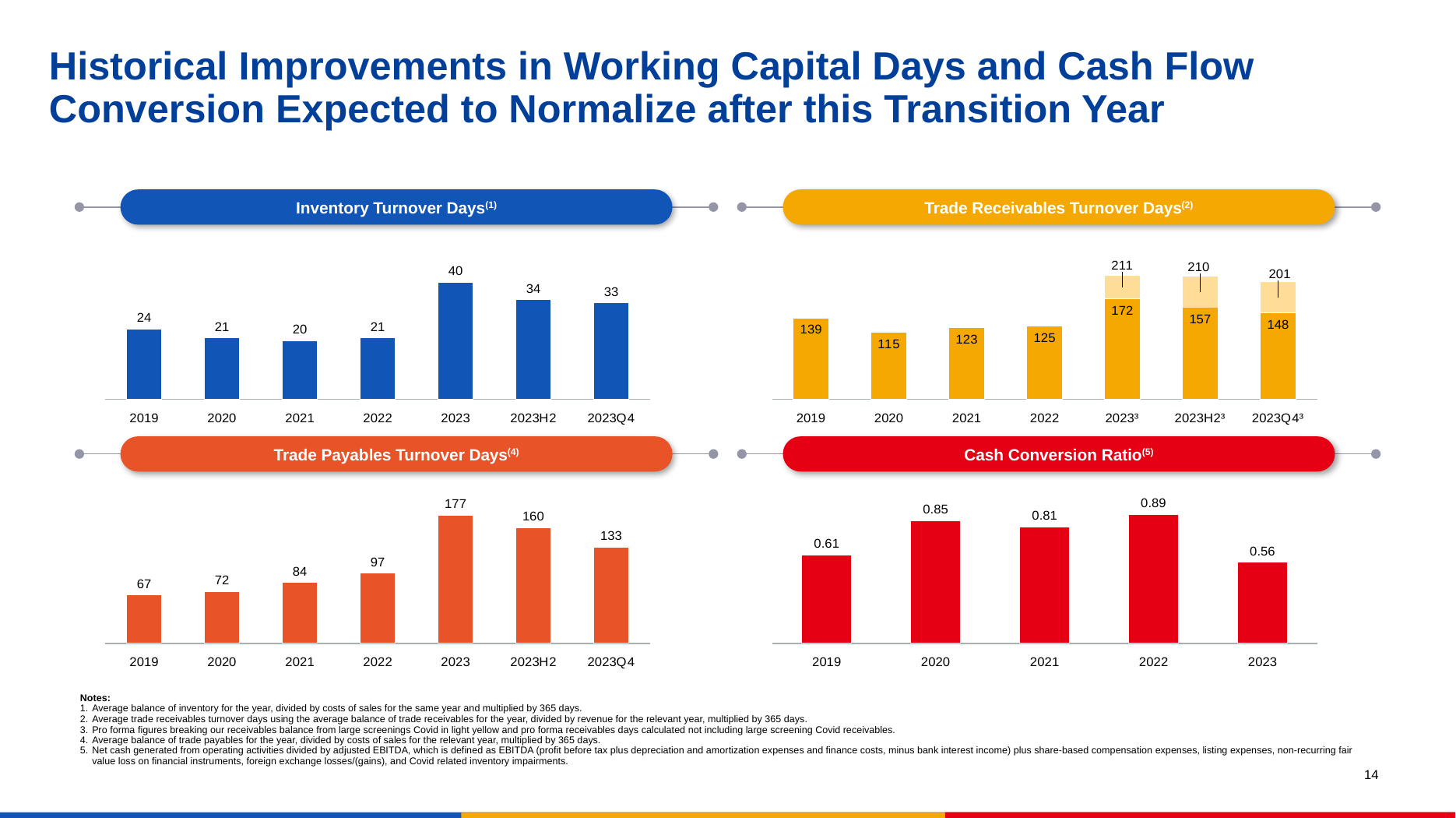
In the Trade Receivables Turnover Days chart, which year from 2019 to 2022 has the lowest value? 2020 In the Trade Receivables Turnover Days chart, what is the total value shown for 2023? 211 How many years are shown on the x axis of the Cash Conversion Ratio chart? 5 In the Cash Conversion Ratio chart, what is the value for 2023? 0.56 In the Inventory Turnover Days chart, what is the value for 2023? 40 What kind of chart is the Inventory Turnover Days chart? bar chart In the Trade Payables Turnover Days chart, do the values rise or fall from 2019 to 2023? rise In the Trade Payables Turnover Days chart, what is the difference between the 2023 value and the 2022 value? 80 In the Inventory Turnover Days chart, which year or period has the lowest value? 2021 In the Cash Conversion Ratio chart, which year has the highest value? 2022 In the Trade Payables Turnover Days chart, what is the value for 2023H2? 160 In the Trade Receivables Turnover Days chart, what is the pro forma value (excluding large screening Covid receivables) for 2023Q4? 148